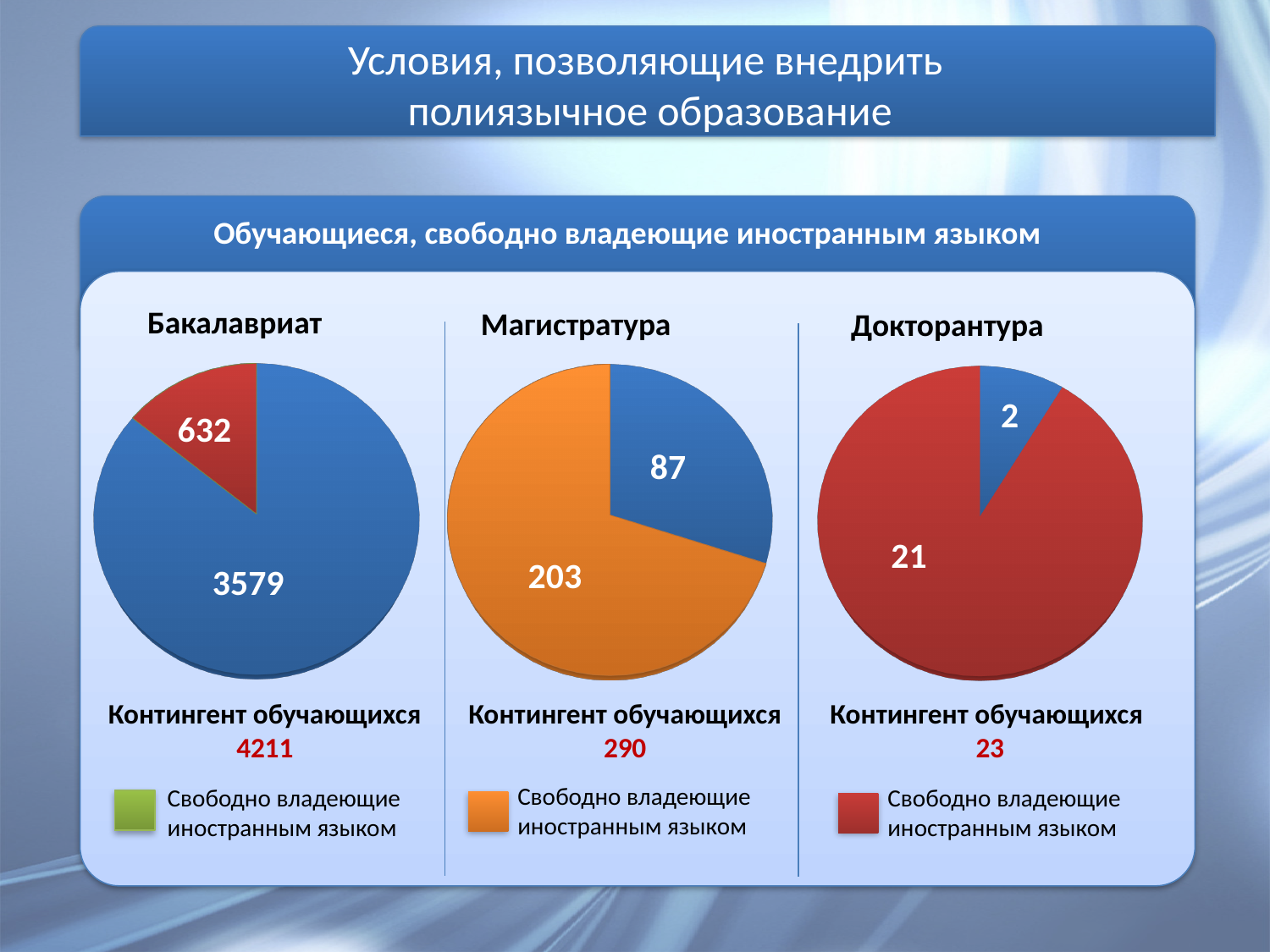
How many pie charts are shown on the slide? 3 In the Бакалавриат pie chart, what is the value of the large blue slice? 3579 What is the total contingent of students shown under the Докторантура chart? 23 What kind of chart is used for Бакалавриат, Магистратура and Докторантура on this slide? Pie chart In the Докторантура pie chart, what is the value of the red slice? 21 In the Магистратура pie chart, what is the value of the orange slice? 203 In the Магистратура pie chart, what is the value of the blue slice? 87 In the Бакалавриат pie chart, which slice is larger, the blue one or the red one? The blue one (3579) In the Магистратура pie chart, what is the difference between the orange slice (203) and the blue slice (87)? 116 In the Докторантура pie chart, what is the value of the blue slice? 2 What is the total contingent of students (Контингент обучающихся) shown under the Бакалавриат chart? 4211 In the Бакалавриат pie chart, what is the value of the red slice? 632